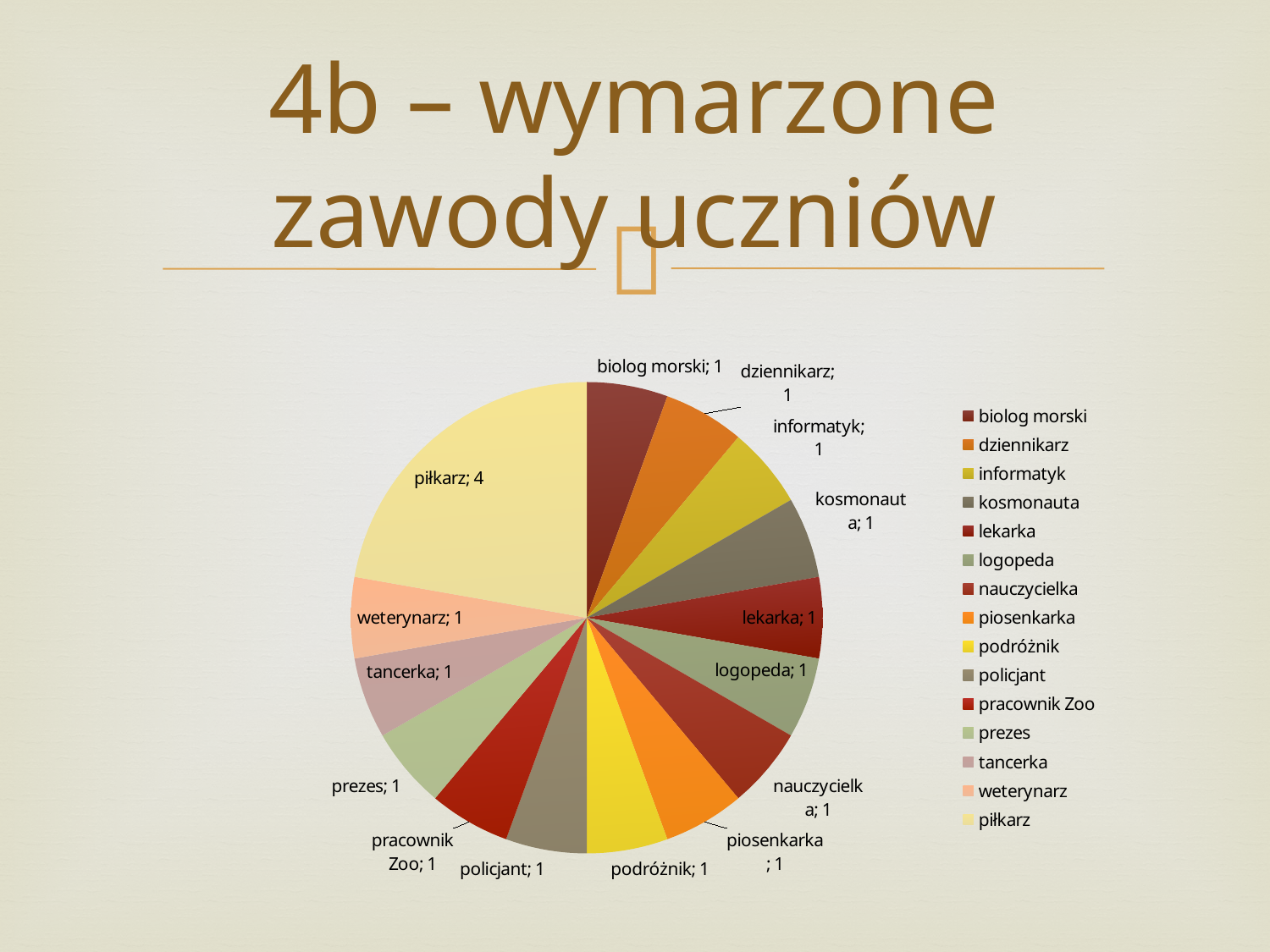
What is the total of all values in the pie chart? 18 How many entries does the legend list? 15 What is the value for pracownik Zoo? 1 What is the difference between the values for piłkarz and weterynarz? 3 What fraction of the total does the piłkarz slice represent? 4/18 Which is larger, the value for piłkarz or the value for policjant? piłkarz What is the value for lekarka? 1 What is the value for piłkarz? 4 Which category has the highest value? piłkarz How many categories (slices) does the pie chart have? 15 What kind of chart is shown on the slide? pie chart What is the title of the slide containing the chart? 4b – wymarzone zawody uczniów